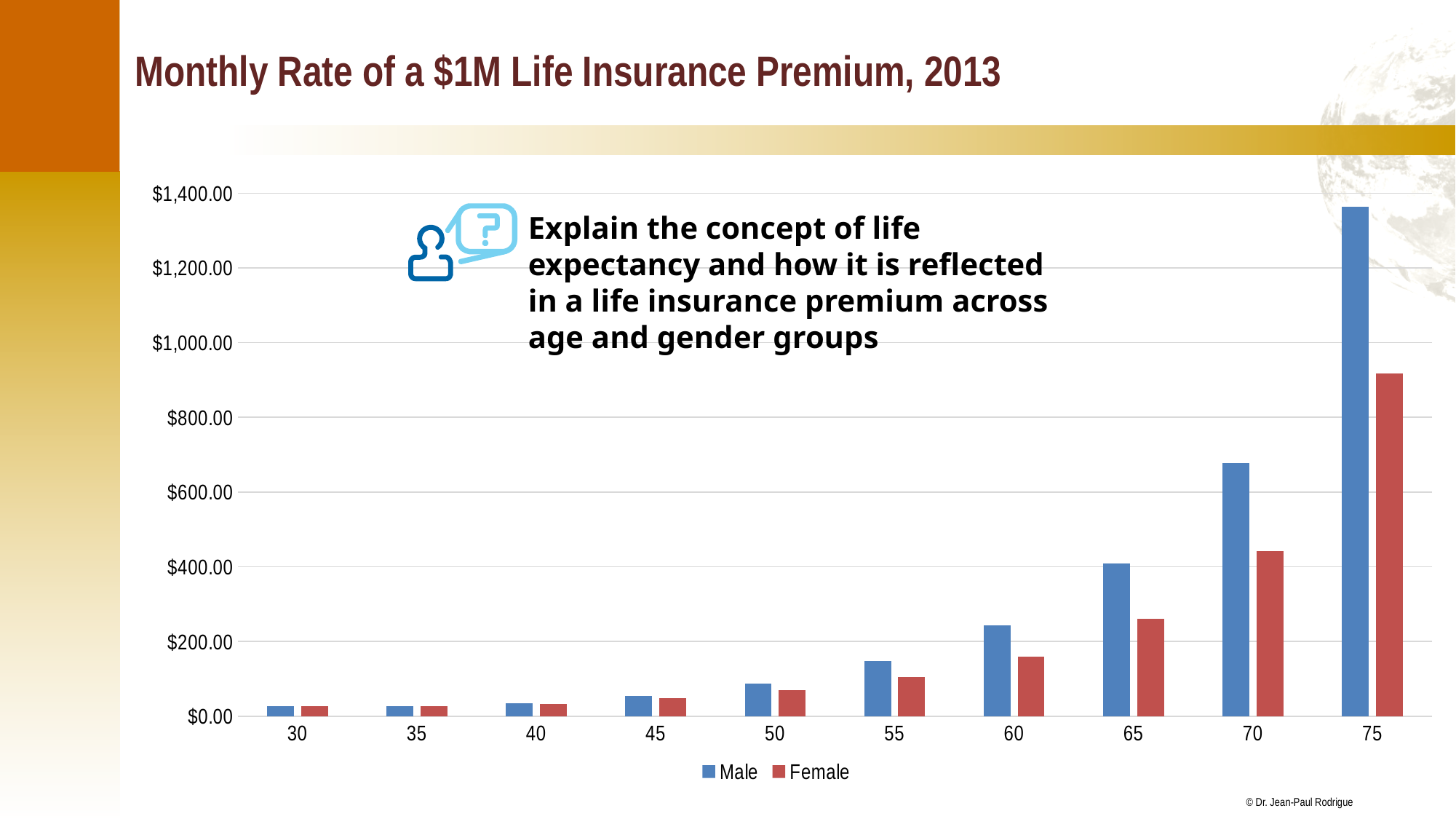
Do the Male premiums rise or fall as age increases along the x axis? rise Is the Female value for age 75 greater or less than $1,000.00? less How many age groups are shown on the x axis? 10 Is the Female value for age 65 greater or less than $400.00? less What is the title of the chart? Monthly Rate of a $1M Life Insurance Premium, 2013 Which age group has the highest Male monthly premium? 75 Is the Male value for age 70 greater or less than $600.00? greater Which age group has the highest Female monthly premium? 75 How many series does the legend list? 2 What kind of chart is shown on the slide? bar chart At age 70, which is larger, the Male or the Female premium? Male